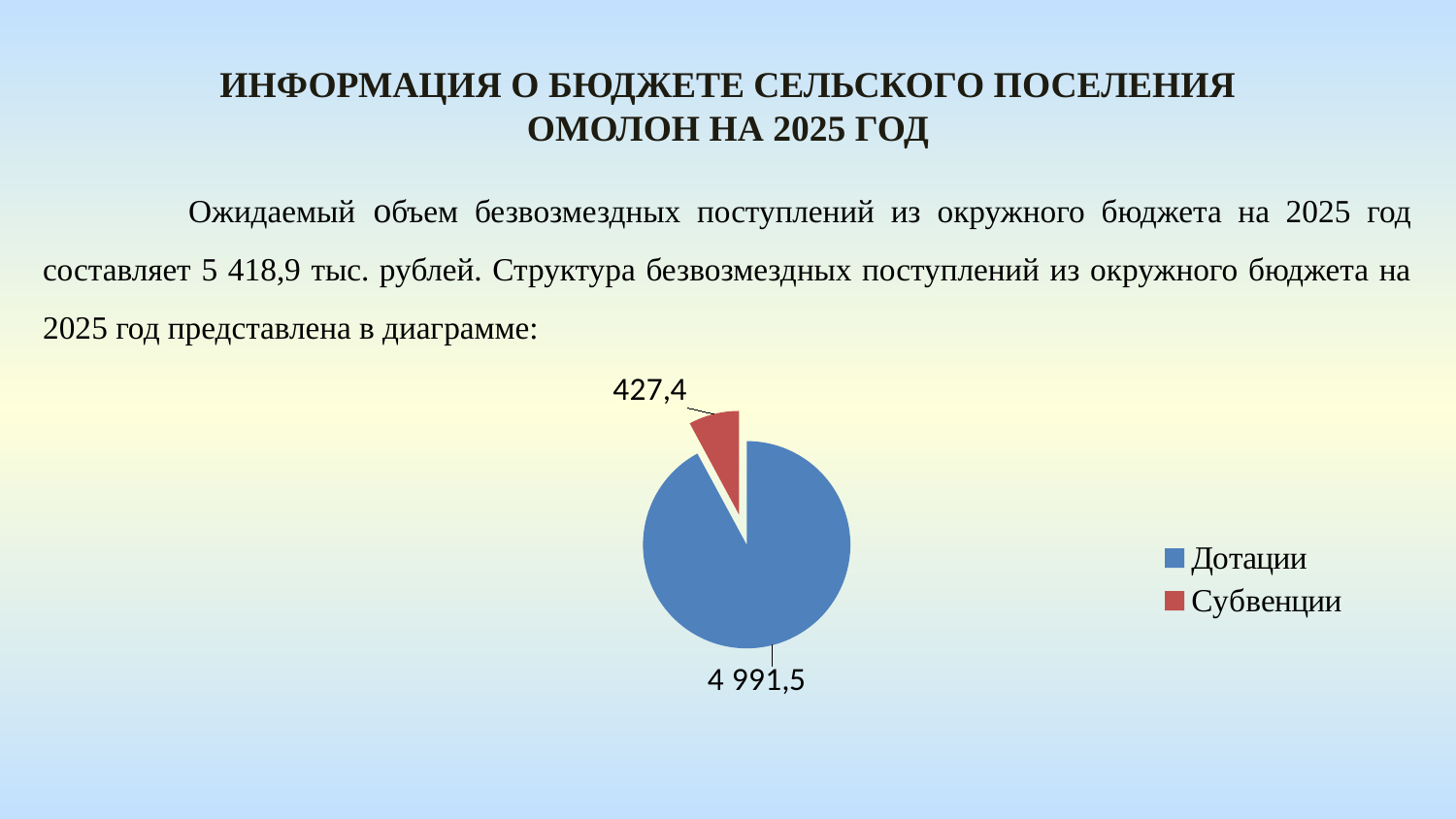
How many entries does the legend of the pie chart list? 2 How many slices does the pie chart have? 2 Which category has the largest slice in the pie chart? Дотации Which is larger, the value for Дотации or the value for Субвенции? Дотации What colour is the Субвенции slice in the pie chart? red What value is shown for Субвенции in the pie chart? 427,4 Which category has the smallest slice in the pie chart? Субвенции What colour is the Дотации slice in the pie chart? blue What is the total of the two slices in the pie chart? 5 418,9 What is the difference between the values for Дотации and Субвенции? 4 564,1 What value is shown for Дотации in the pie chart? 4 991,5 What kind of chart is shown on the slide? pie chart